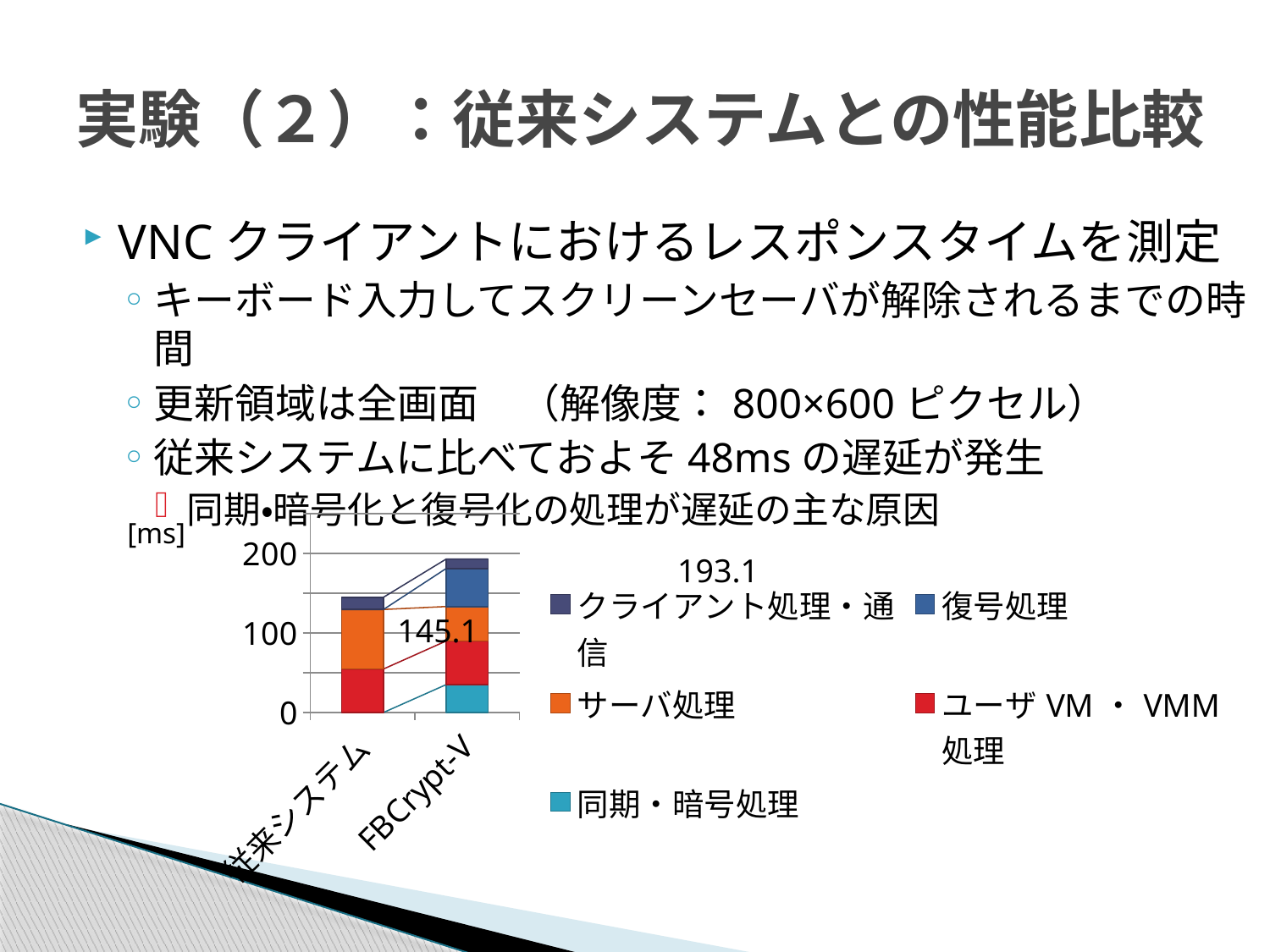
How many series does the chart's legend list? 5 What kind of chart is shown on the slide? stacked bar chart Which legend entry is shown in light blue (the bottom segment of the FBCrypt-V bar)? 同期・暗号処理 What is the total response time labelled for FBCrypt-V? 193.1 Which category has the higher total response time? FBCrypt-V Which category has the lower total response time? 従来システム How many categories are shown on the x axis of the chart? 2 Is the total value for FBCrypt-V greater or less than 200? less Is the total for 従来システム larger or smaller than the total for FBCrypt-V? smaller What is the difference between the total for FBCrypt-V and the total for 従来システム? 48.0 What is the total response time labelled for 従来システム? 145.1 What unit is shown on the y axis of the chart? [ms]